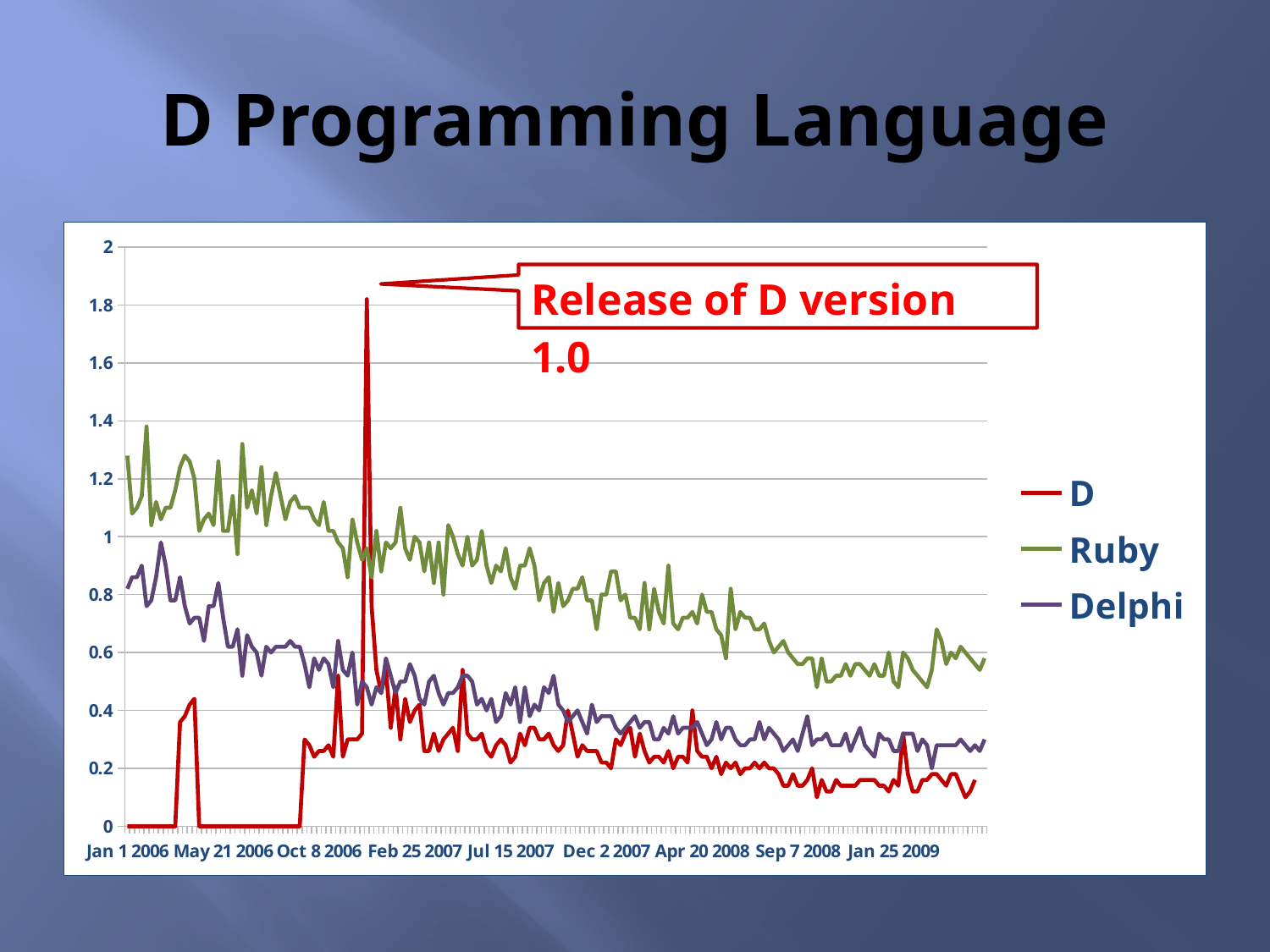
What does the red annotation box on the chart say? Release of D version 1.0 Does the Ruby series generally rise or fall from Jan 1 2006 to Jan 25 2009? fall Does the Delphi series generally rise or fall across the x axis? fall Is the peak value of the D series greater or less than 1.6? greater How many series does the legend list? 3 Is the value of Ruby at Jan 1 2006 greater or less than 1? greater Which series is lower at Jan 25 2009, D or Delphi? D Which series reaches the highest peak value on the chart? D Which series has the lowest value at Jan 1 2006? D What kind of chart is shown on the slide? line chart Which series are listed in the legend? D, Ruby, Delphi Which series has the highest value at Jan 1 2006? Ruby